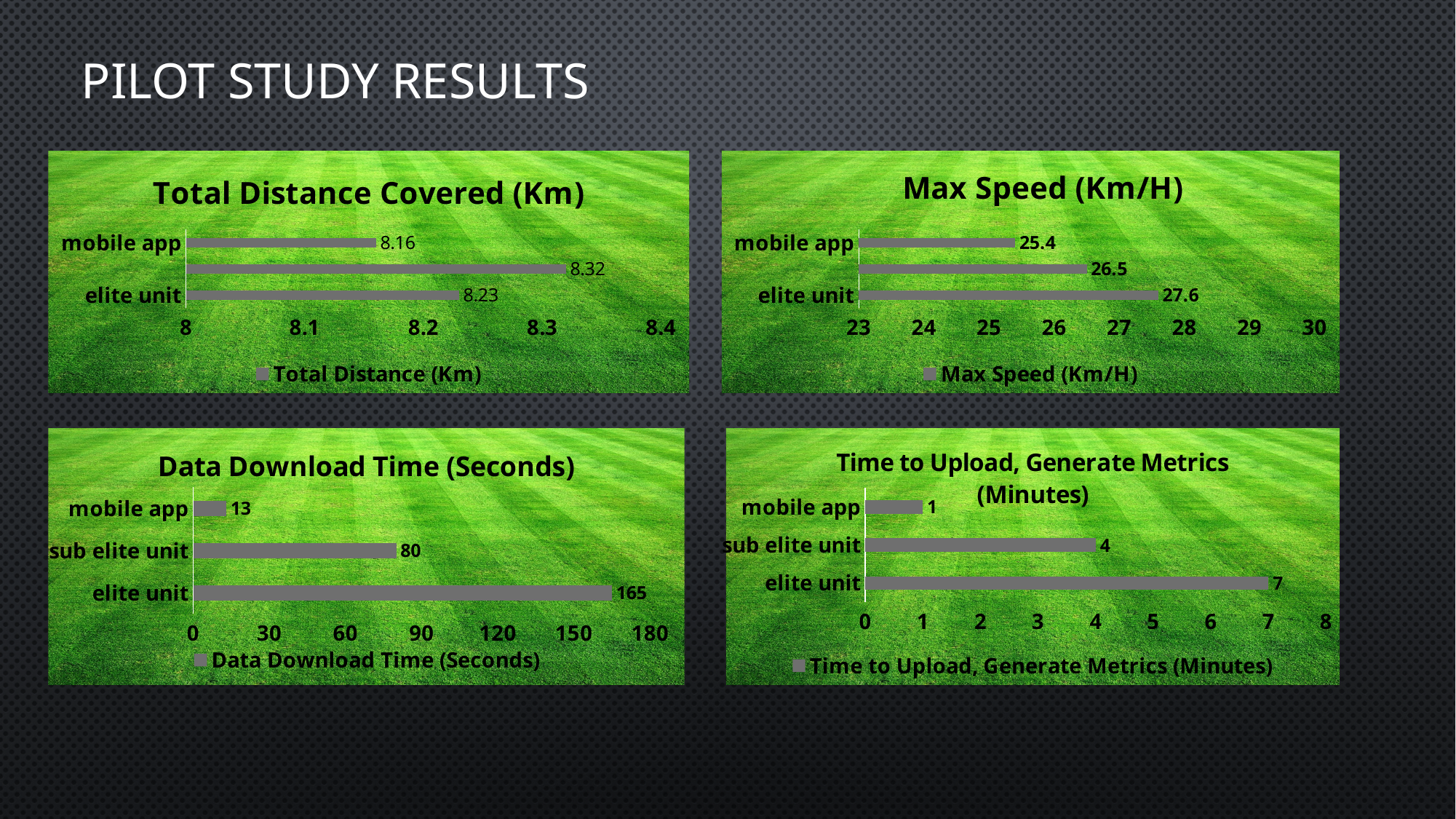
In the Max Speed (Km/H) chart, what is the value for elite unit? 27.6 In the Max Speed (Km/H) chart, what is the difference between elite unit and mobile app? 2.2 In the Total Distance Covered (Km) chart, which labelled category has the lowest value? mobile app In the Total Distance Covered (Km) chart, what is the value for elite unit? 8.23 In the Data Download Time (Seconds) chart, what is the value for sub elite unit? 80 In the Time to Upload, Generate Metrics (Minutes) chart, what is the value for sub elite unit? 4 In the Data Download Time (Seconds) chart, how many categories are shown? 3 In the Data Download Time (Seconds) chart, what is the difference between elite unit and mobile app? 152 In the Total Distance Covered (Km) chart, what is the value for mobile app? 8.16 In the Max Speed (Km/H) chart, which category has the highest value? elite unit In the Time to Upload, Generate Metrics (Minutes) chart, which is larger, elite unit or mobile app? elite unit What type of chart is the Data Download Time (Seconds) chart? bar chart